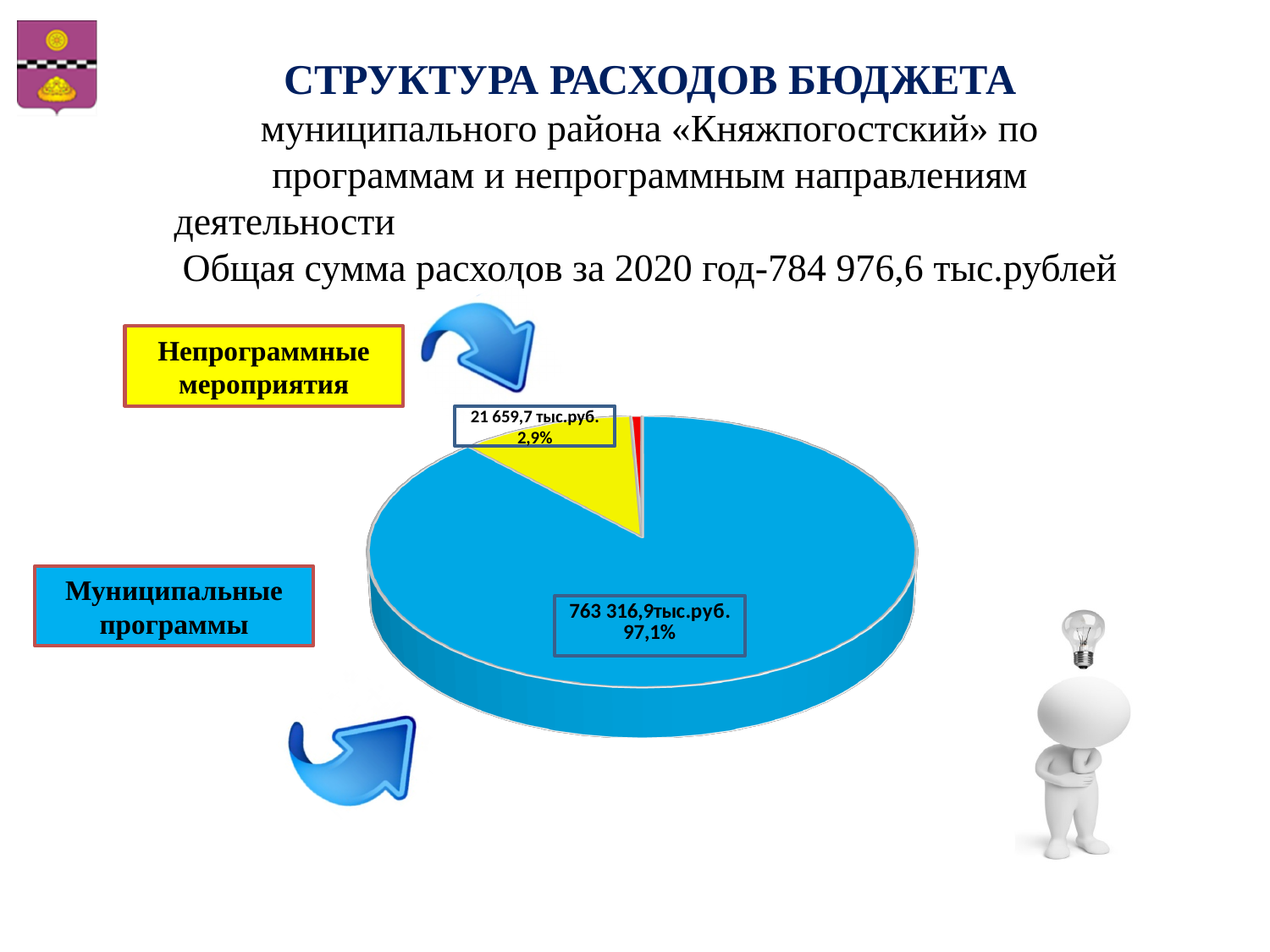
What colour is the slice for Муниципальные программы? blue What is the value shown for Непрограммные мероприятия? 21 659,7 тыс.руб. What kind of chart is shown on the slide? pie chart Which category has the largest slice of the pie? Муниципальные программы Which of the two labelled categories has the smaller slice? Непрограммные мероприятия What share of the pie does Муниципальные программы take? 97,1% Which is larger, Муниципальные программы or Непрограммные мероприятия? Муниципальные программы What is the total sum of expenditures for 2020 stated on the slide? 784 976,6 тыс.рублей What is the difference in тыс.руб. between Муниципальные программы and Непрограммные мероприятия? 741 657,2 тыс.руб. What is the value shown for Муниципальные программы? 763 316,9тыс.руб. What share of the pie does Непрограммные мероприятия take? 2,9% What colour is the slice for Непрограммные мероприятия? yellow